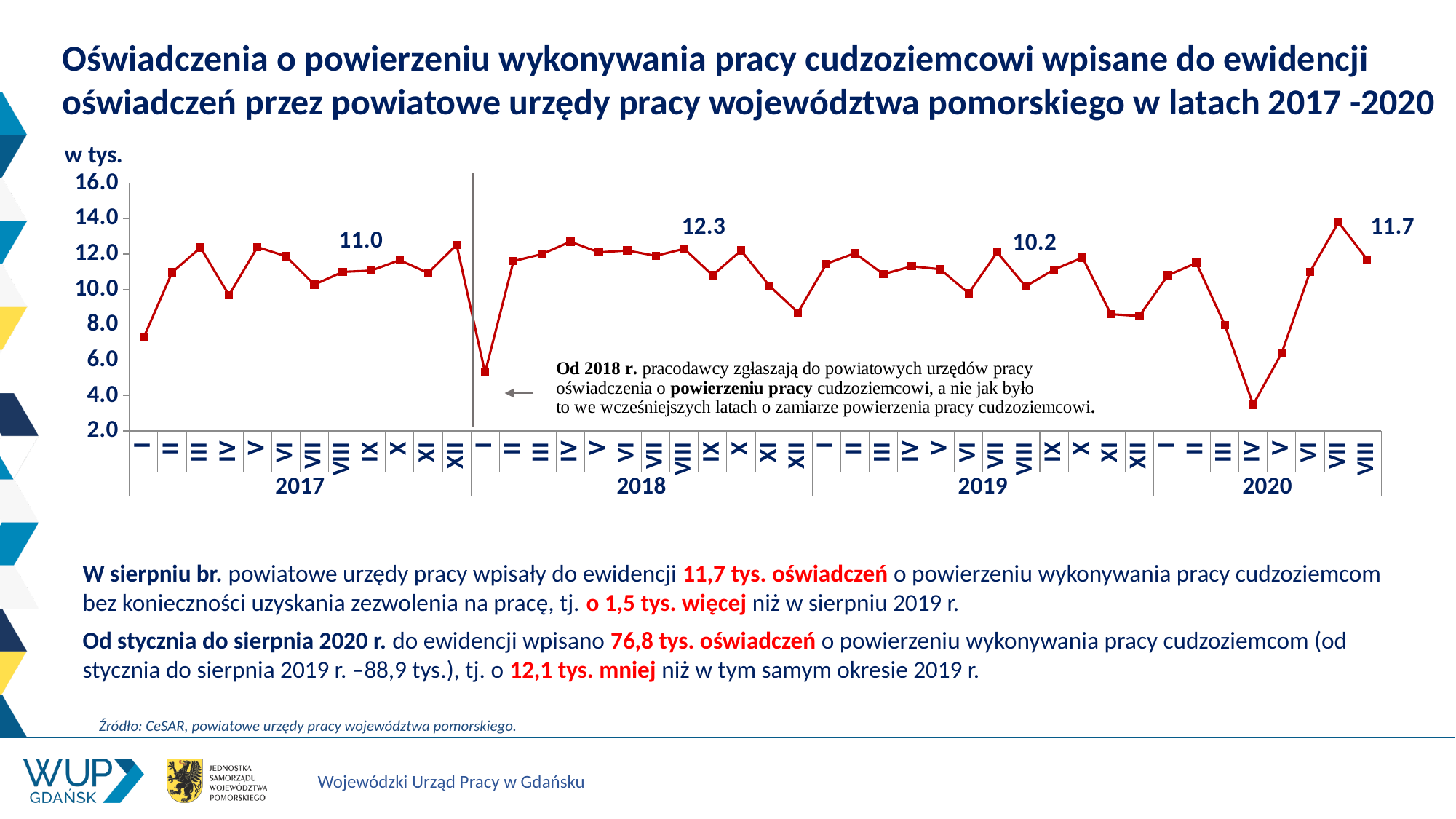
What is the value for August (VIII) 2019? 10.2 Is the value for January (I) 2018 greater or less than 6.0? less Which month has the lowest value on the chart? IV 2020 What kind of chart is shown on the slide? line chart Which month has the highest value on the chart? VII 2020 What is the value for August (VIII) 2018? 12.3 Which is larger, the value for August 2018 or the value for August 2019? August 2018 By how much does the value for August 2020 exceed the value for August 2019? 1.5 What is the value for August (VIII) 2020? 11.7 What is the difference between the values for August 2018 and August 2017? 1.3 Is the value for April (IV) 2020 greater or less than 4.0? less What is the value for August (VIII) 2017? 11.0